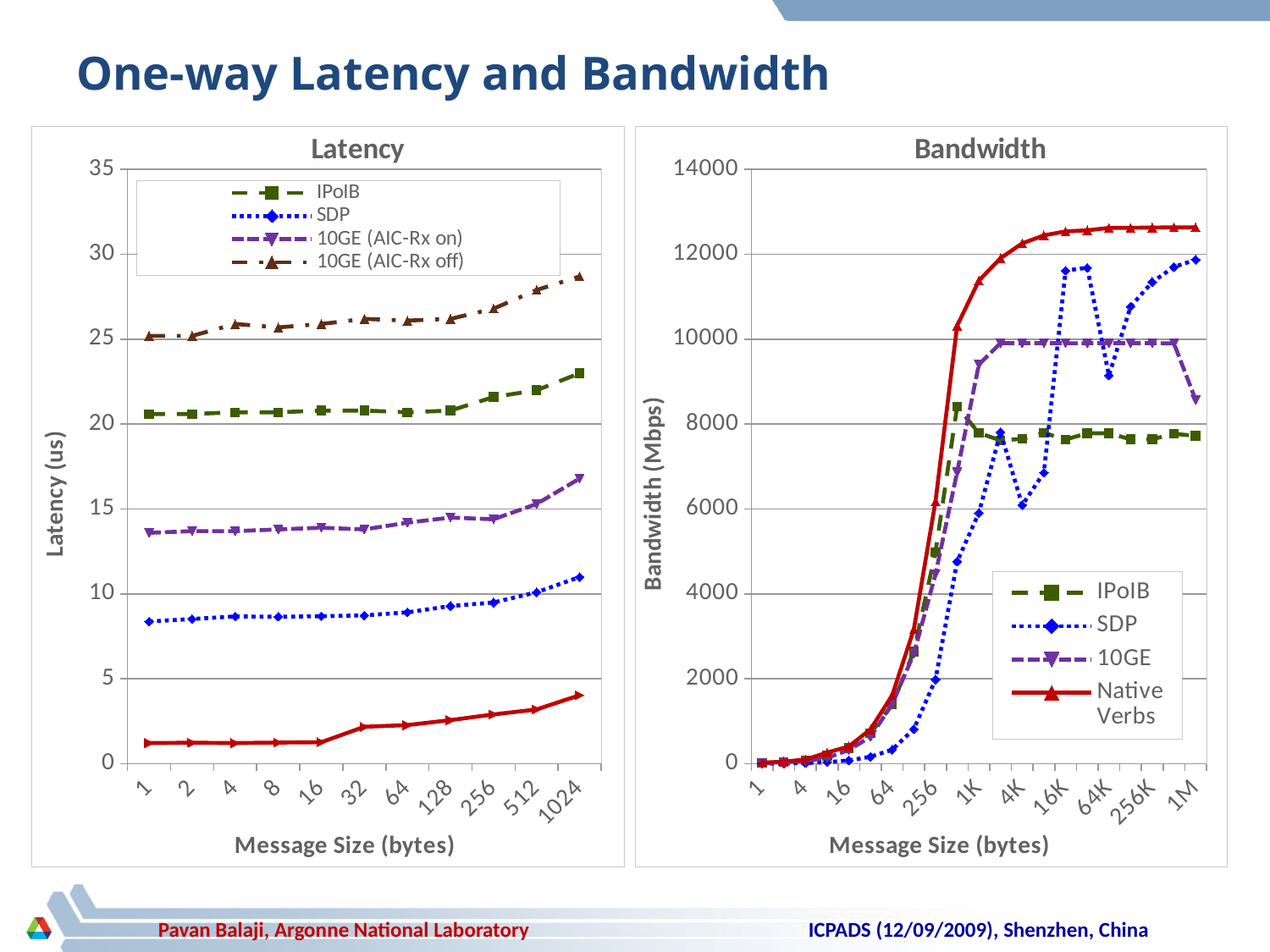
In the Bandwidth chart, is the Native Verbs bandwidth at 1M bytes greater or less than 12000? greater In the Latency chart, is the IPoIB latency at 1024 bytes greater or less than 25? less How many series does the legend of the Bandwidth chart list? 4 How many message sizes are shown on the x axis of the Latency chart? 11 How many series does the legend of the Latency chart list? 4 In the Latency chart, is the SDP latency at 1 byte greater or less than 10? less In the Latency chart, does the IPoIB latency rise or fall as message size increases? Rise In the Latency chart, which is larger at 1 byte, the IPoIB latency or the SDP latency? IPoIB What kind of chart is the Latency chart? Line chart In the Latency chart, which series has the highest latency at 1024 bytes? 10GE (AIC-Rx off) In the Bandwidth chart, which is larger at 1M bytes, the SDP bandwidth or the 10GE bandwidth? SDP In the Bandwidth chart, which series has the highest bandwidth at 1M bytes? Native Verbs